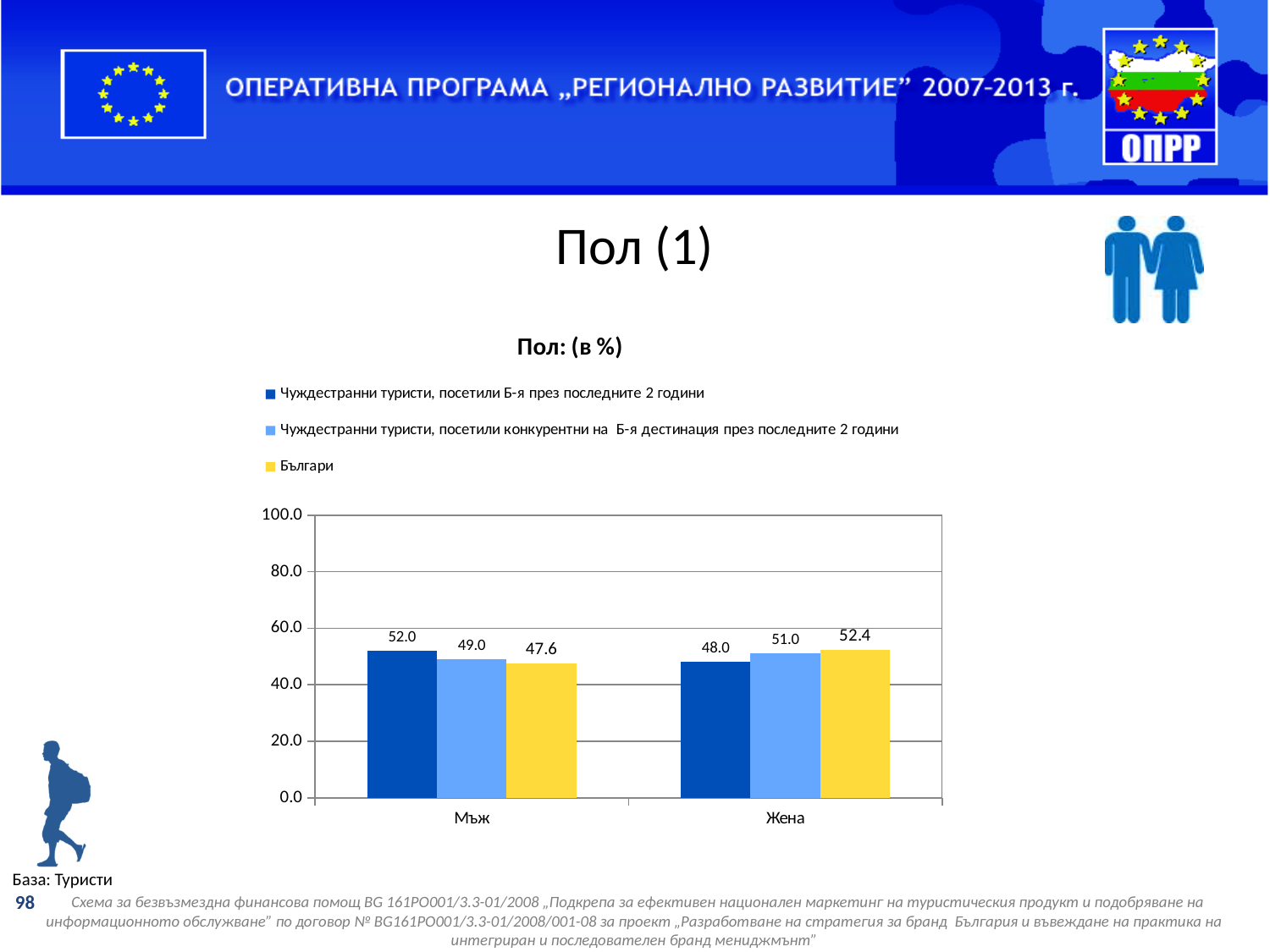
What is the value for Жена in the series "Чуждестранни туристи, посетили Б-я през последните 2 години"? 48.0 What is the value for Жена in the series "Българи"? 52.4 What is the value for Мъж in the series "Чуждестранни туристи, посетили конкурентни на Б-я дестинация през последните 2 години"? 49.0 How many series does the legend list? 3 What is the difference between the Мъж and Жена values in the series "Българи"? 4.8 What is the value for Мъж in the series "Чуждестранни туристи, посетили Б-я през последните 2 години"? 52.0 What is the title of the chart? Пол: (в %) Which series has the lowest value for Мъж? Българи Which is larger: the Мъж value or the Жена value in the series "Чуждестранни туристи, посетили Б-я през последните 2 години"? Мъж What type of chart is shown on the slide? bar chart Which series has the highest value for Жена? Българи How many categories are shown on the x axis? 2